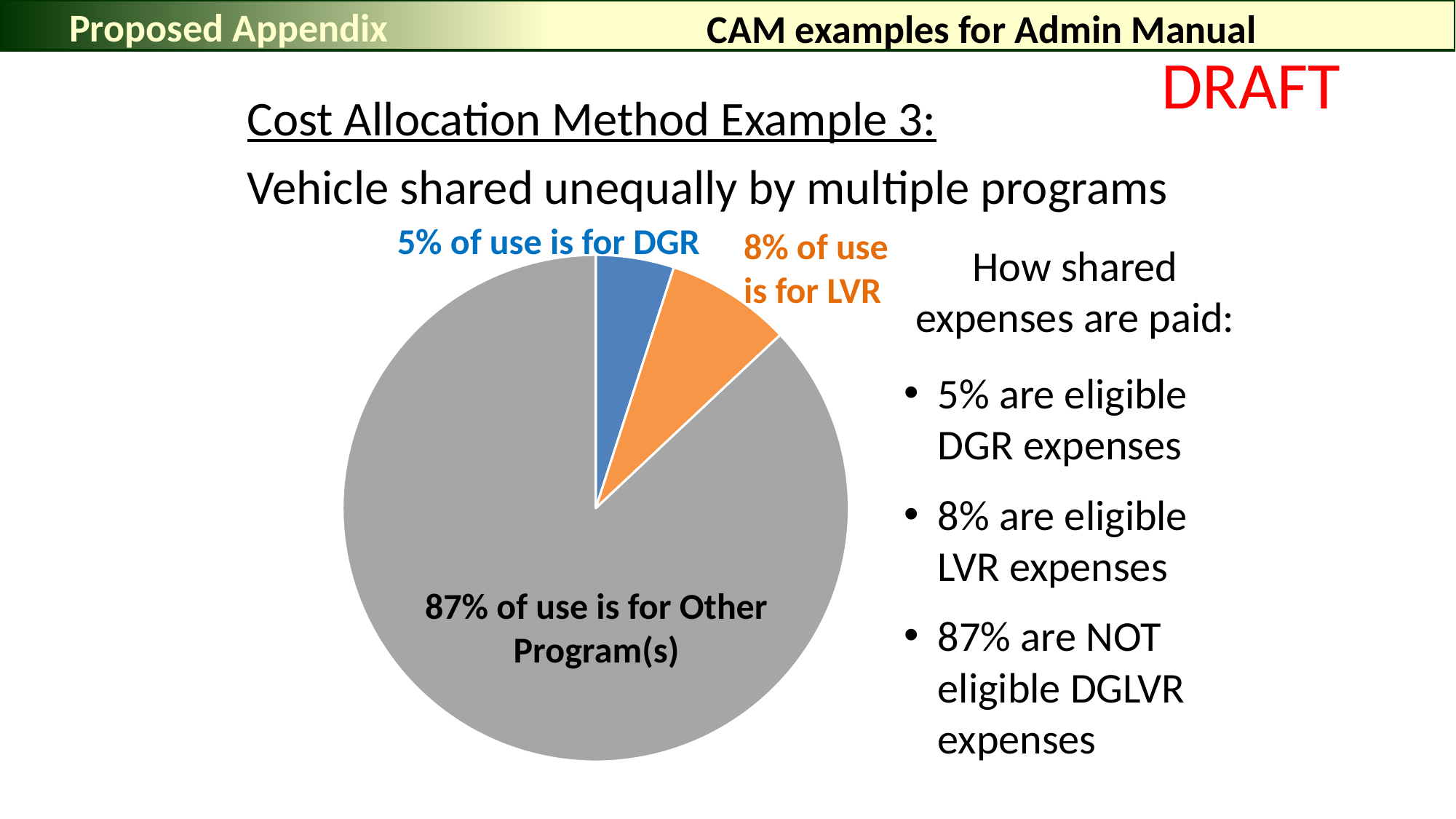
How many slices does the pie chart have? 3 What colour is the slice representing DGR use? Blue What kind of chart is shown on the slide? Pie chart What is the difference in percentage points between the LVR share and the DGR share of use? 3% What colour is the slice representing Other Program(s) use? Gray What percentage of vehicle use is for Other Program(s) according to the pie chart? 87% Which slice of the pie chart is the largest? Other Program(s) Which is larger, the share of use for LVR or the share of use for DGR? LVR What percentage of vehicle use is for LVR according to the pie chart? 8% Which slice of the pie chart is the smallest? DGR What is the combined share of use for DGR and LVR? 13% What percentage of vehicle use is for DGR according to the pie chart? 5%